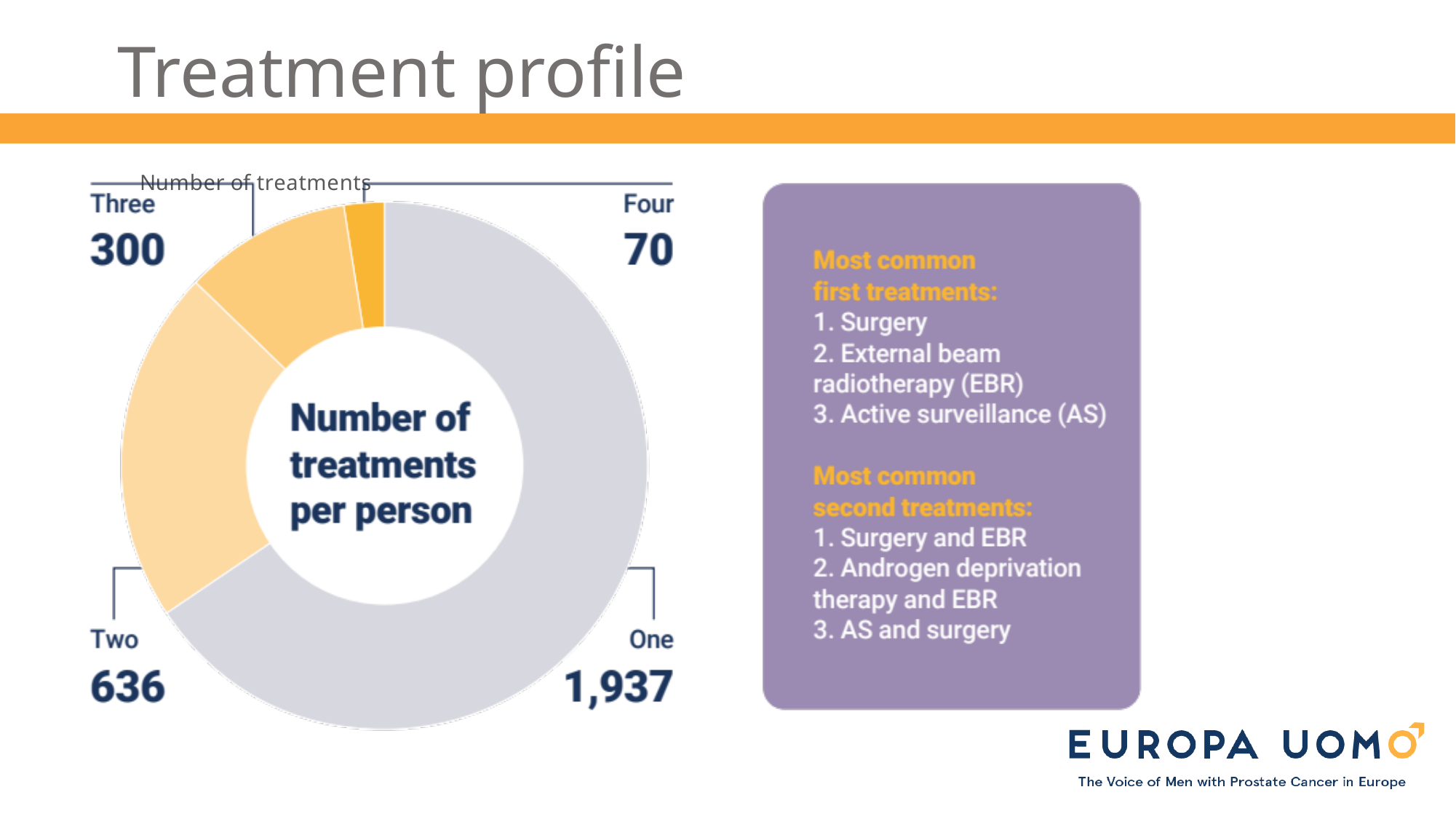
What is the total of all four values in the chart? 2,943 Which is larger, the value for 'Two' treatments or the value for 'Three' treatments? Two What is the value shown for 'Three' treatments per person? 300 Which number of treatments per person has the smallest slice? Four Which number of treatments per person has the largest slice? One What is the value shown for 'Two' treatments per person? 636 What is the difference between the values for 'One' and 'Two' treatments? 1,301 How many people had one treatment according to the chart? 1,937 How many categories does the chart show? 4 What is the difference between the values for 'Three' and 'Four' treatments? 230 What is the value shown for 'Four' treatments per person? 70 What kind of chart is shown on the slide? Donut chart